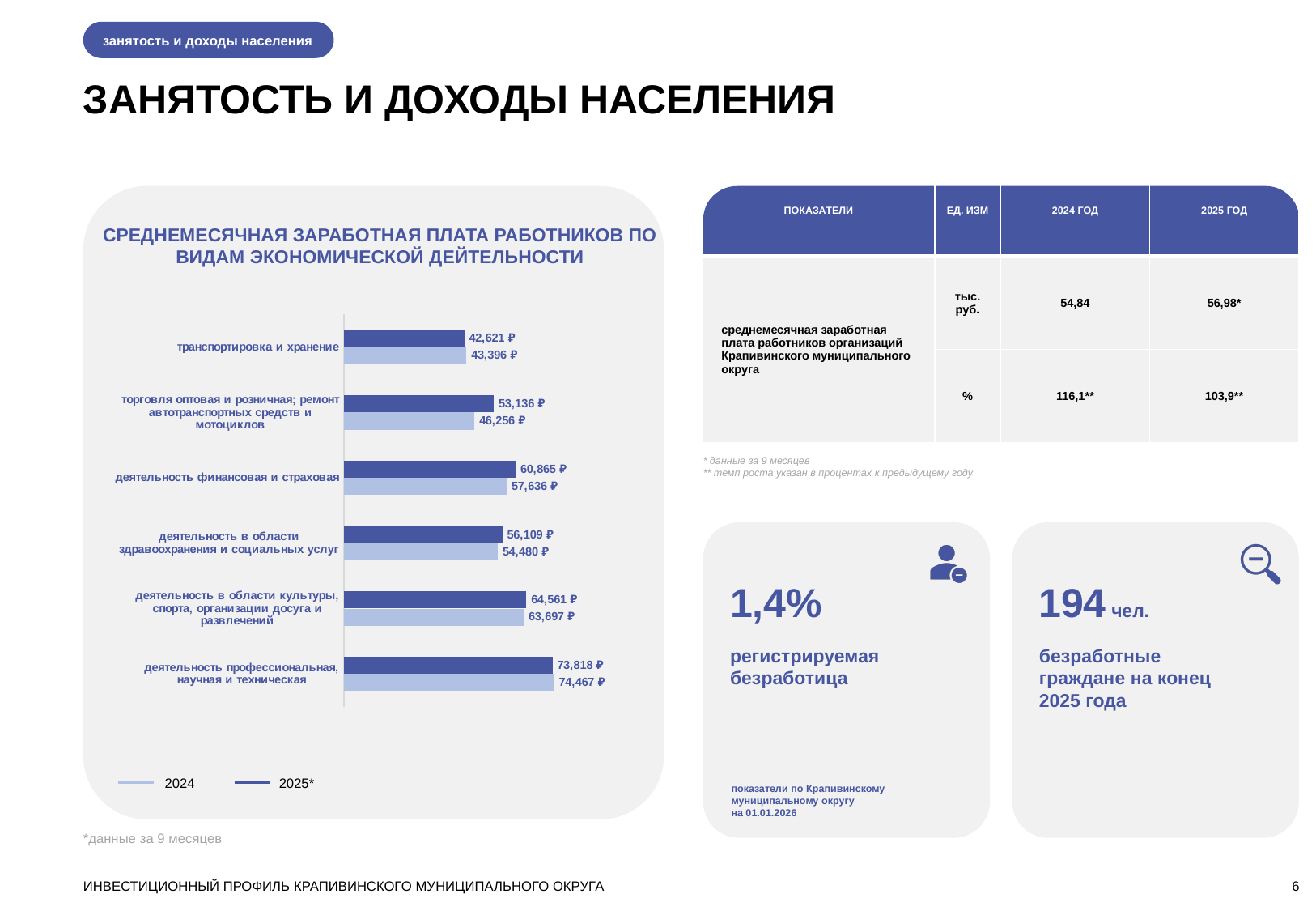
Which is larger for «деятельность в области здравоохранения и социальных услуг»: the 2024 value or the 2025* value? 2025* What is the 2024 value for «торговля оптовая и розничная; ремонт автотранспортных средств и мотоциклов»? 46,256 ₽ Which series is shown with the darker blue bars in the chart? 2025* Which category has the highest 2025* value? деятельность профессиональная, научная и техническая What type of chart is shown on the slide? bar chart What is the 2024 value for «транспортировка и хранение»? 43,396 ₽ Which category has the lowest 2024 value? транспортировка и хранение What is the difference between the 2025* and 2024 values for «деятельность финансовая и страховая»? 3,229 ₽ How many series does the chart legend list? 2 What is the 2025* value for «деятельность профессиональная, научная и техническая»? 73,818 ₽ How many categories (types of economic activity) are shown in the chart? 6 What is the difference between the 2025* and 2024 values for «торговля оптовая и розничная; ремонт автотранспортных средств и мотоциклов»? 6,880 ₽